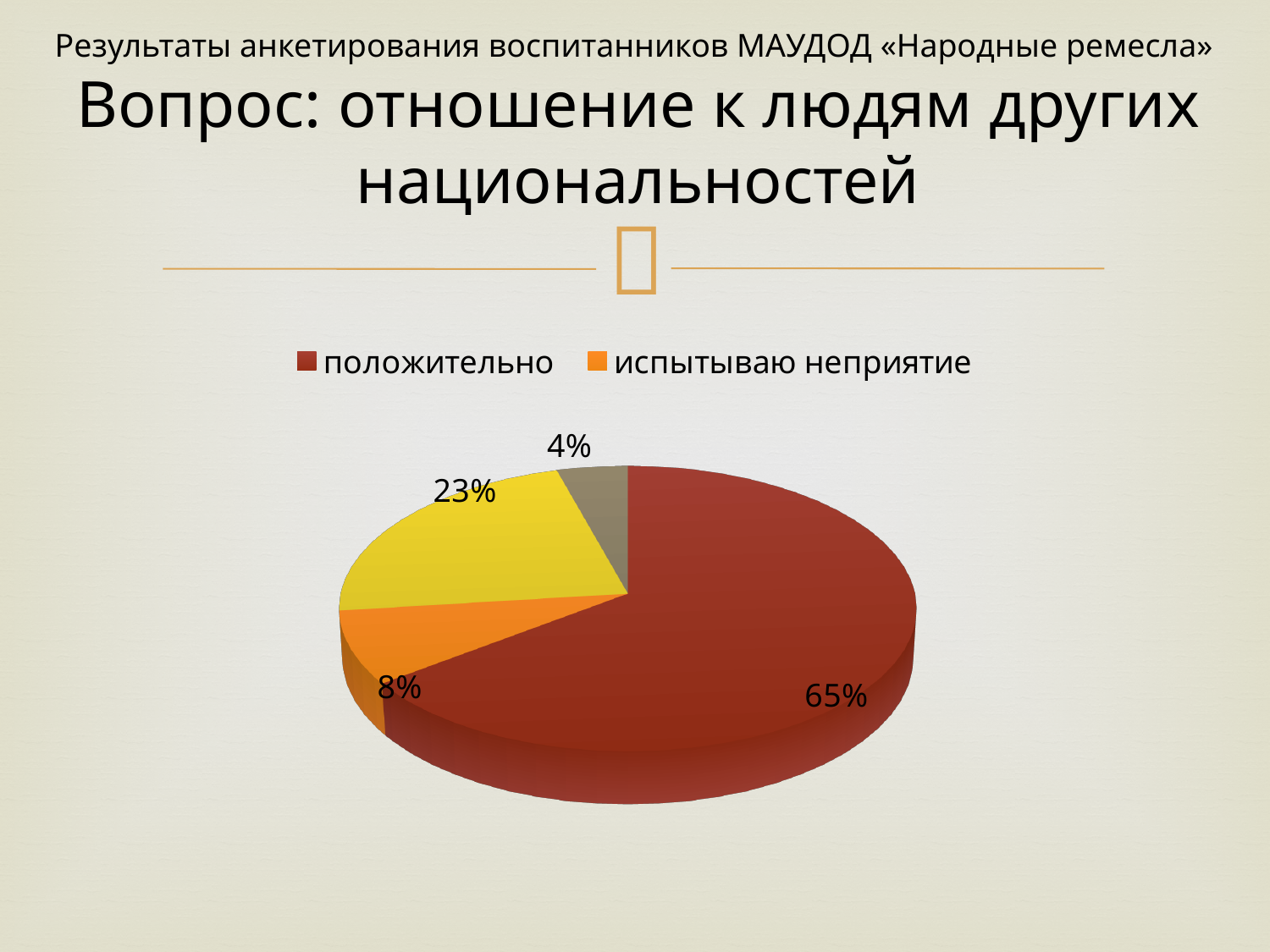
What is the value of the smallest slice in the pie chart? 4% Which is larger: the "положительно" slice or the "испытываю неприятие" slice? положительно What share of respondents answered "положительно"? 65% What colour is the "положительно" slice in the pie chart? dark red What colour is the "испытываю неприятие" slice in the pie chart? orange How many slices does the pie chart have? 4 What is the difference between the "положительно" slice and the "испытываю неприятие" slice? 57% Which legend category has the largest slice of the pie? положительно What kind of chart is shown on the slide? pie chart How many entries does the legend list? 2 What is the value of the largest slice in the pie chart? 65% What share of respondents answered "испытываю неприятие"? 8%